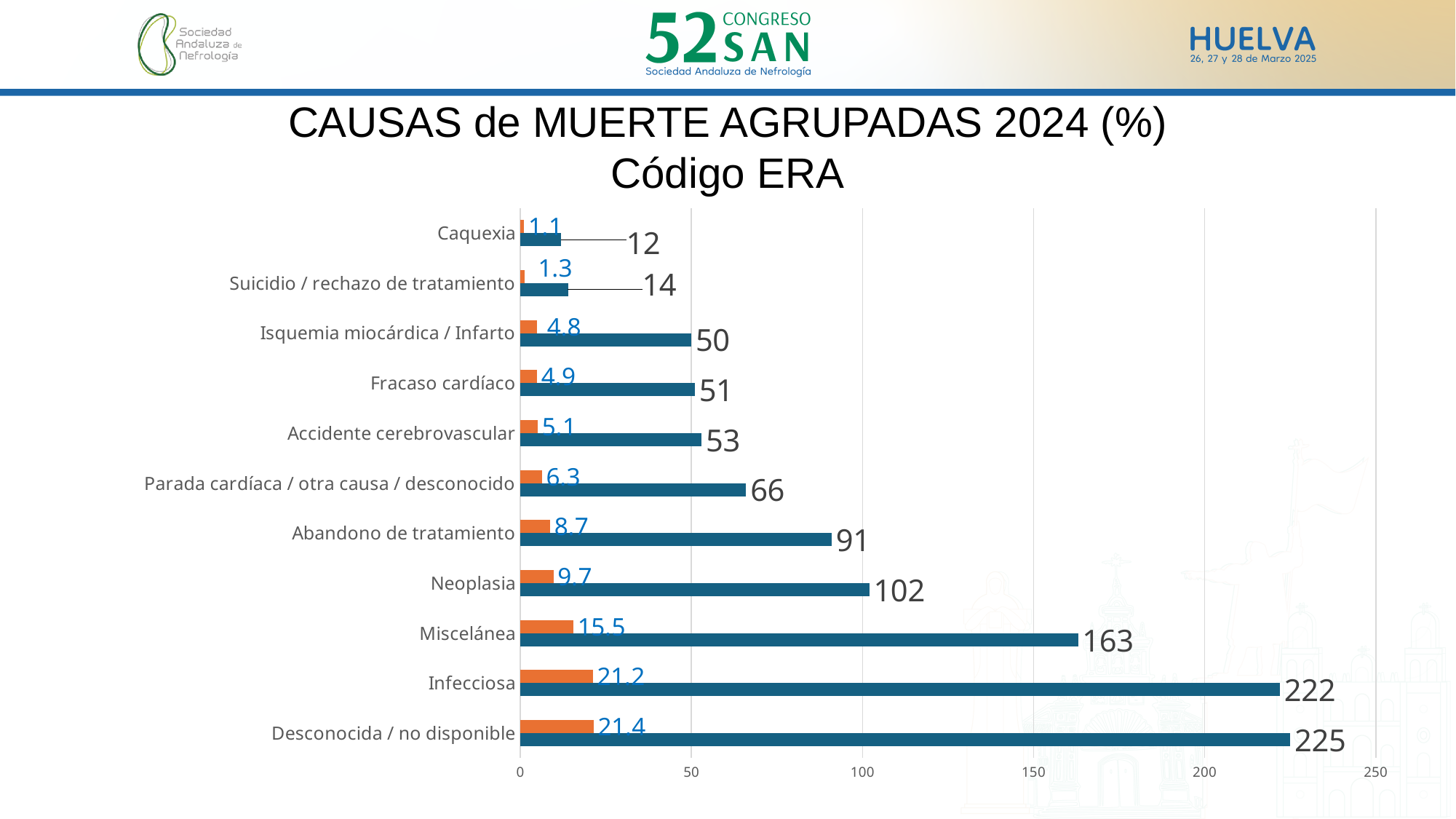
Is the blue bar value for Miscelánea greater or less than 150? greater What is the difference between the blue bar values for Desconocida / no disponible and Infecciosa? 3 Which has a larger blue bar value, Parada cardíaca / otra causa / desconocido or Accidente cerebrovascular? Parada cardíaca / otra causa / desconocido What is the difference between the blue bar values for Miscelánea and Neoplasia? 61 What is the value shown on the blue bar for Infecciosa? 222 What is the value shown on the blue bar for Abandono de tratamiento? 91 Which category has the lowest orange bar value? Caquexia What is the value shown on the orange bar for Miscelánea? 15.5 What type of chart is shown on the slide? Bar chart How many categories are shown on the chart? 11 Which category has the highest blue bar value? Desconocida / no disponible What is the value shown on the orange bar for Neoplasia? 9.7